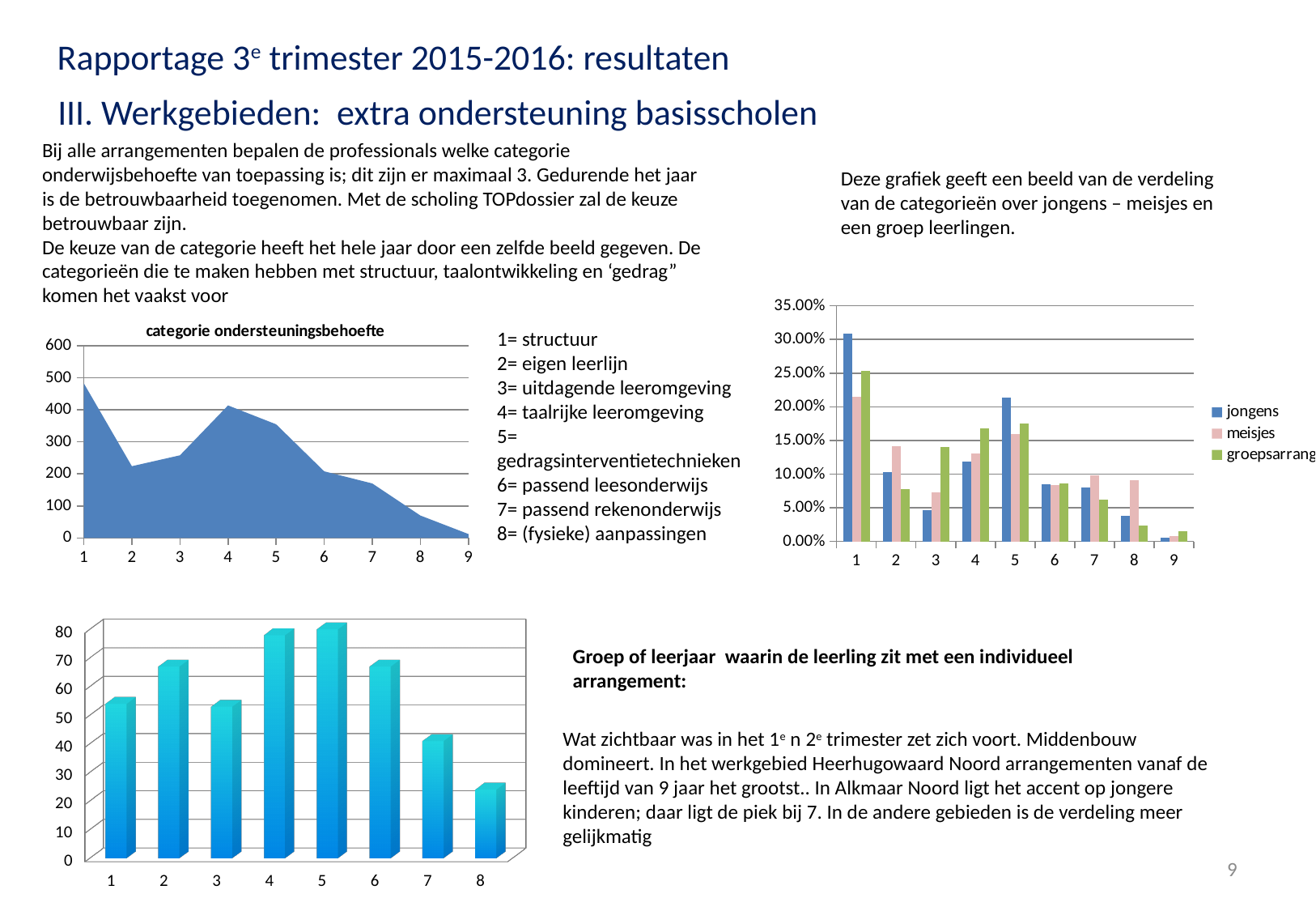
In the bottom-left bar chart, which is larger, the value for category 2 or the value for category 7? category 2 In the chart titled 'categorie ondersteuningsbehoefte', which category has the highest value? 1 In the chart titled 'categorie ondersteuningsbehoefte', is the value for category 8 greater or less than 100? less In the chart titled 'categorie ondersteuningsbehoefte', is the value for category 1 greater or less than 400? greater In the bottom-left bar chart, is the value for category 8 greater or less than 30? less What kind of chart is the bottom-left chart with categories 1 to 8? bar chart How many categories are shown on the x axis of the bottom-left bar chart? 8 How many series does the legend of the top-right bar chart list? 3 In the bottom-left bar chart, which category has the lowest value? 8 In the top-right bar chart, which is larger at category 1, jongens or meisjes? jongens